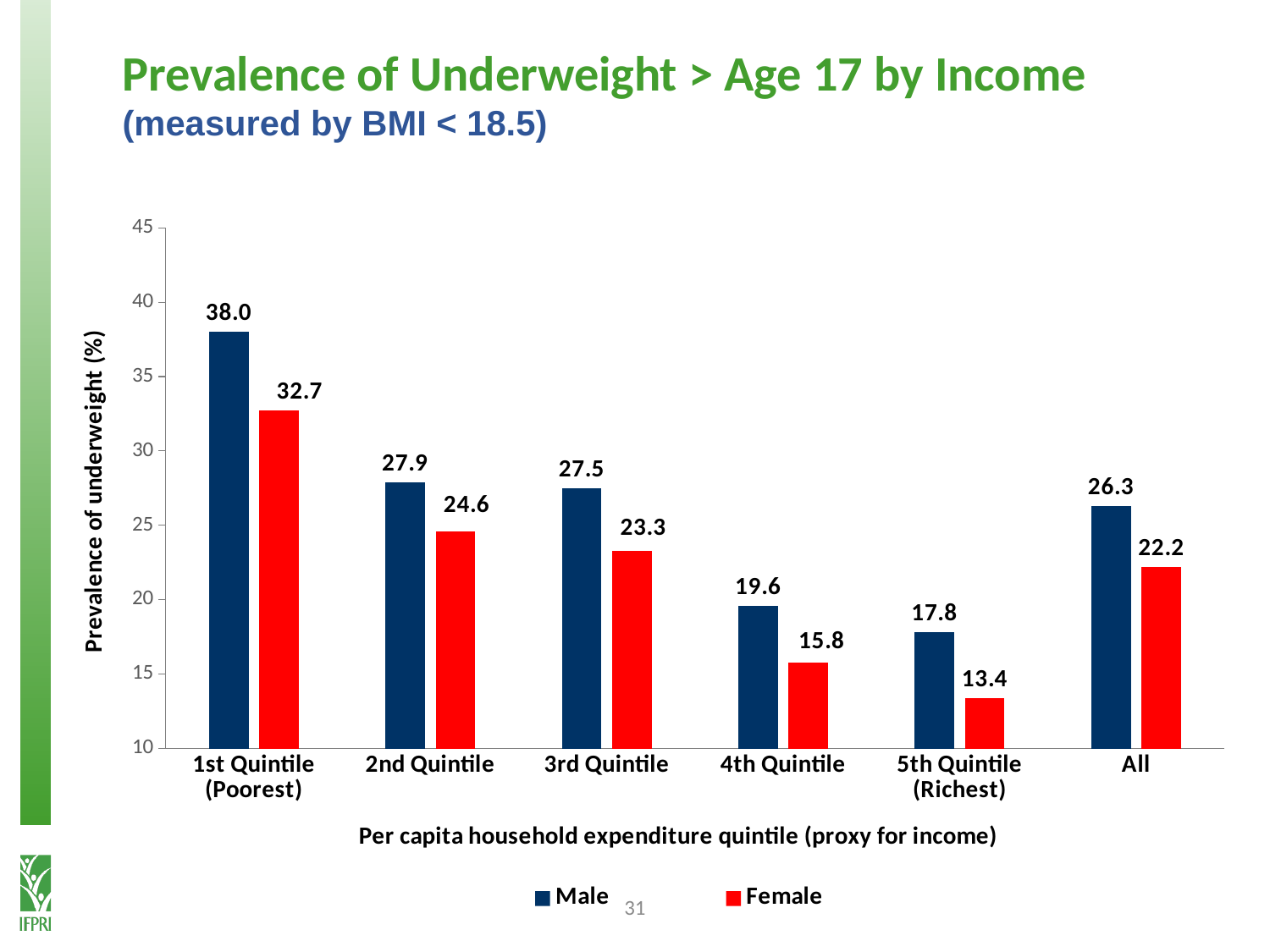
What kind of chart is shown on the slide? bar chart Is the Male value for All greater or less than 25? greater How many series does the legend list? 2 What is the Female value for the 5th Quintile (Richest)? 13.4 Do the Female values rise or fall from the 1st Quintile to the 5th Quintile? fall How many categories are shown on the x axis? 6 Which is larger, the Male value for the 4th Quintile or the Female value for the 4th Quintile? Male Which category has the lowest Female value? 5th Quintile (Richest) What is the Male value for the 1st Quintile (Poorest)? 38.0 Which category has the highest Male value? 1st Quintile (Poorest) What is the difference between the Male and Female values for the 2nd Quintile? 3.3 What is the Female value for the 3rd Quintile? 23.3